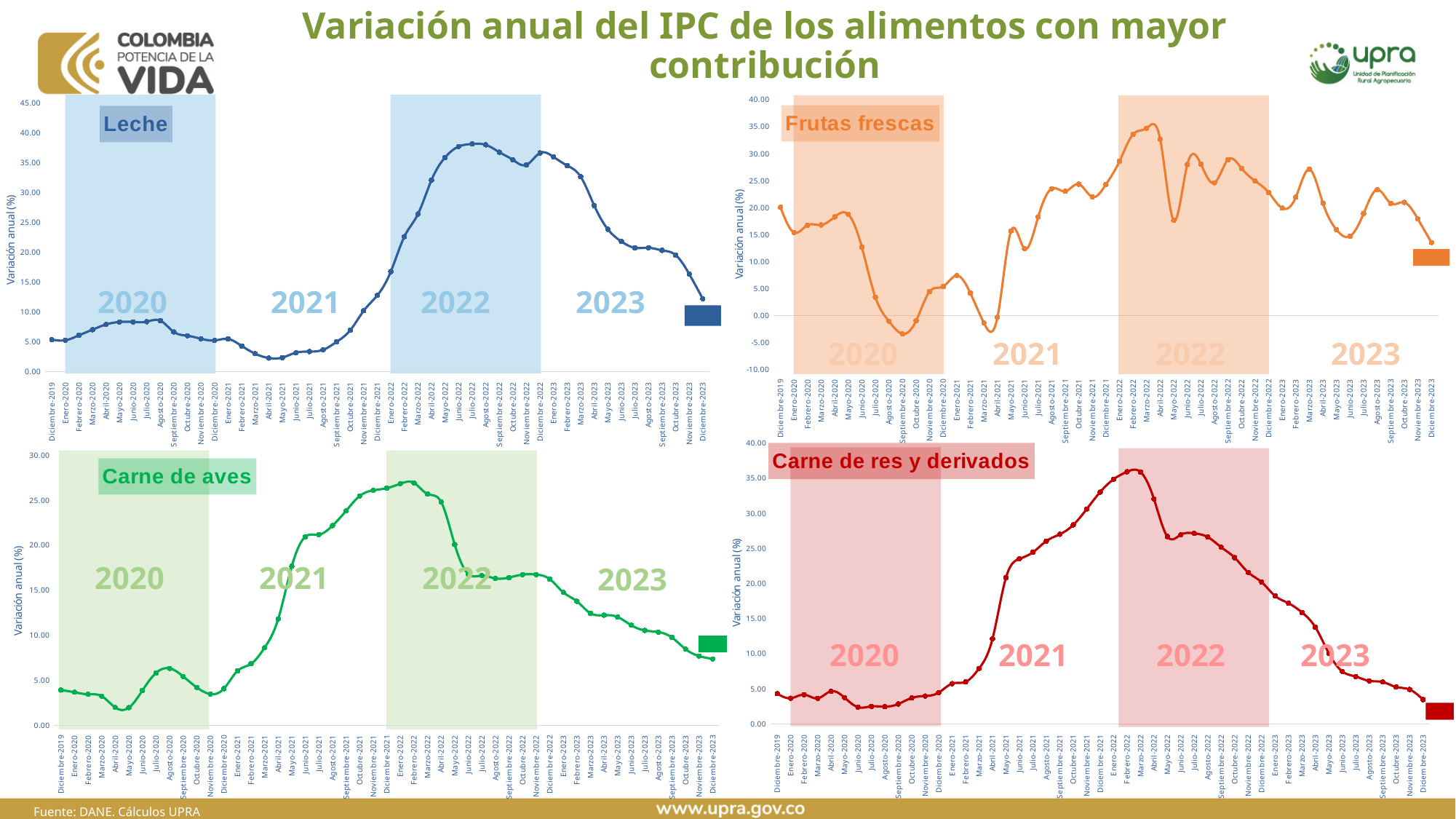
In the Carne de res y derivados chart, is the value for Marzo-2022 greater or less than 30? greater In the Leche chart, is the value for Diciembre-2019 greater or less than 10? less How many charts are shown on the slide? 4 In the Carne de aves chart, is the value for Febrero-2022 greater or less than 25? greater In the Leche chart, which is larger, the value for Julio-2022 or the value for Diciembre-2023? Julio-2022 What kind of chart is used for the Leche panel? line chart In the Carne de res y derivados chart, do the values rise or fall from Marzo-2022 to Diciembre-2023? fall What is the source cited at the bottom of the slide? Fuente: DANE. Cálculos UPRA